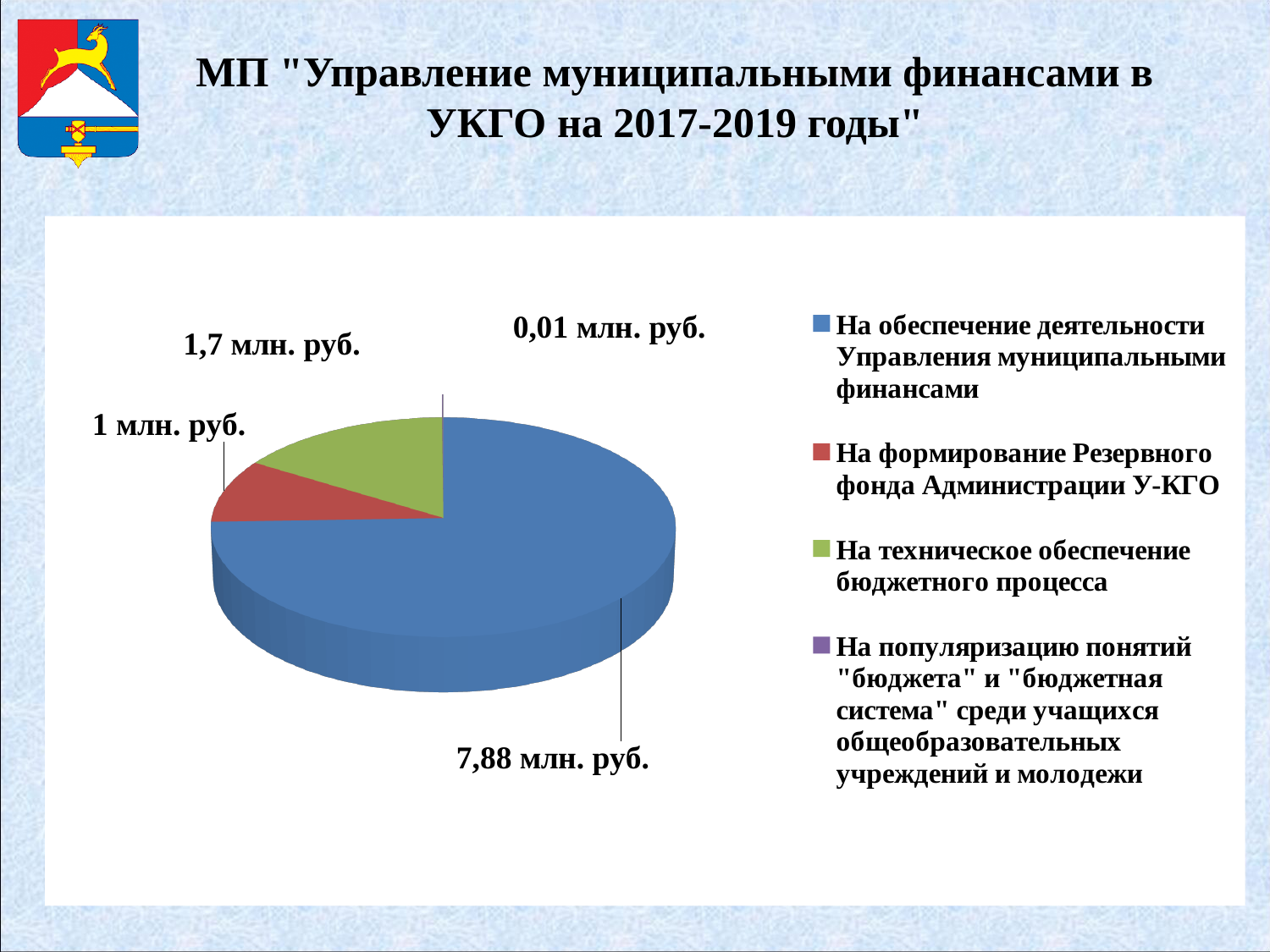
What is the value for "На популяризацию понятий "бюджета" и "бюджетная система" среди учащихся общеобразовательных учреждений и молодежи"? 0,01 млн. руб. Which is larger: the value for "На техническое обеспечение бюджетного процесса" or the value for "На формирование Резервного фонда Администрации У-КГО"? На техническое обеспечение бюджетного процесса What colour is the slice for "На формирование Резервного фонда Администрации У-КГО"? Red Which category has the smallest slice of the pie? На популяризацию понятий "бюджета" и "бюджетная система" среди учащихся общеобразовательных учреждений и молодежи What kind of chart is shown on the slide? Pie chart What is the total of all the values shown on the pie chart? 10,59 млн. руб. What is the value for "На формирование Резервного фонда Администрации У-КГО"? 1 млн. руб. What is the value for "На обеспечение деятельности Управления муниципальными финансами"? 7,88 млн. руб. What is the difference between the value for "На техническое обеспечение бюджетного процесса" and the value for "На формирование Резервного фонда Администрации У-КГО"? 0,7 млн. руб. Which category has the largest slice of the pie? На обеспечение деятельности Управления муниципальными финансами How many categories does the legend of the pie chart list? 4 What is the value for "На техническое обеспечение бюджетного процесса"? 1,7 млн. руб.